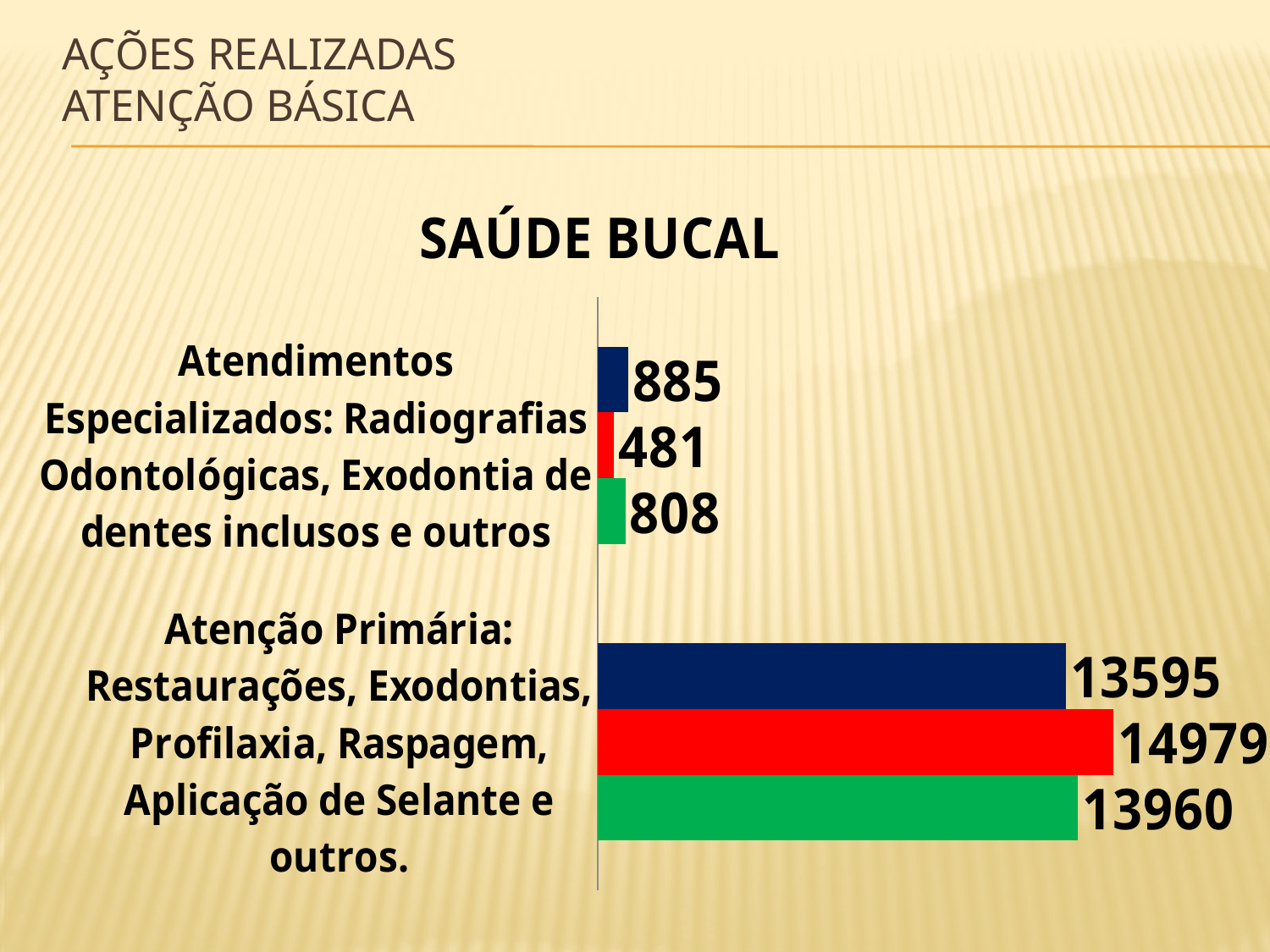
What is the difference between the dark blue bar (885) and the green bar (808) in the 'Atendimentos Especializados' category? 77 What is the value of the dark blue bar for the 'Atendimentos Especializados' category? 885 How many categories does the chart show? 2 What is the value of the green bar for the 'Atenção Primária' category? 13960 What is the value of the red bar for the 'Atenção Primária' category? 14979 What kind of chart is shown on the slide? bar chart Which bar has the lowest value in the chart? the red bar for Atendimentos Especializados (481) What is the value of the red bar for the 'Atendimentos Especializados' category? 481 Which bar has the highest value in the chart? the red bar for Atenção Primária (14979) What is the title of the chart? SAÚDE BUCAL What is the difference between the red bar (14979) and the dark blue bar (13595) in the 'Atenção Primária' category? 1384 In the 'Atendimentos Especializados' category, which is larger: the dark blue bar or the green bar? the dark blue bar (885)